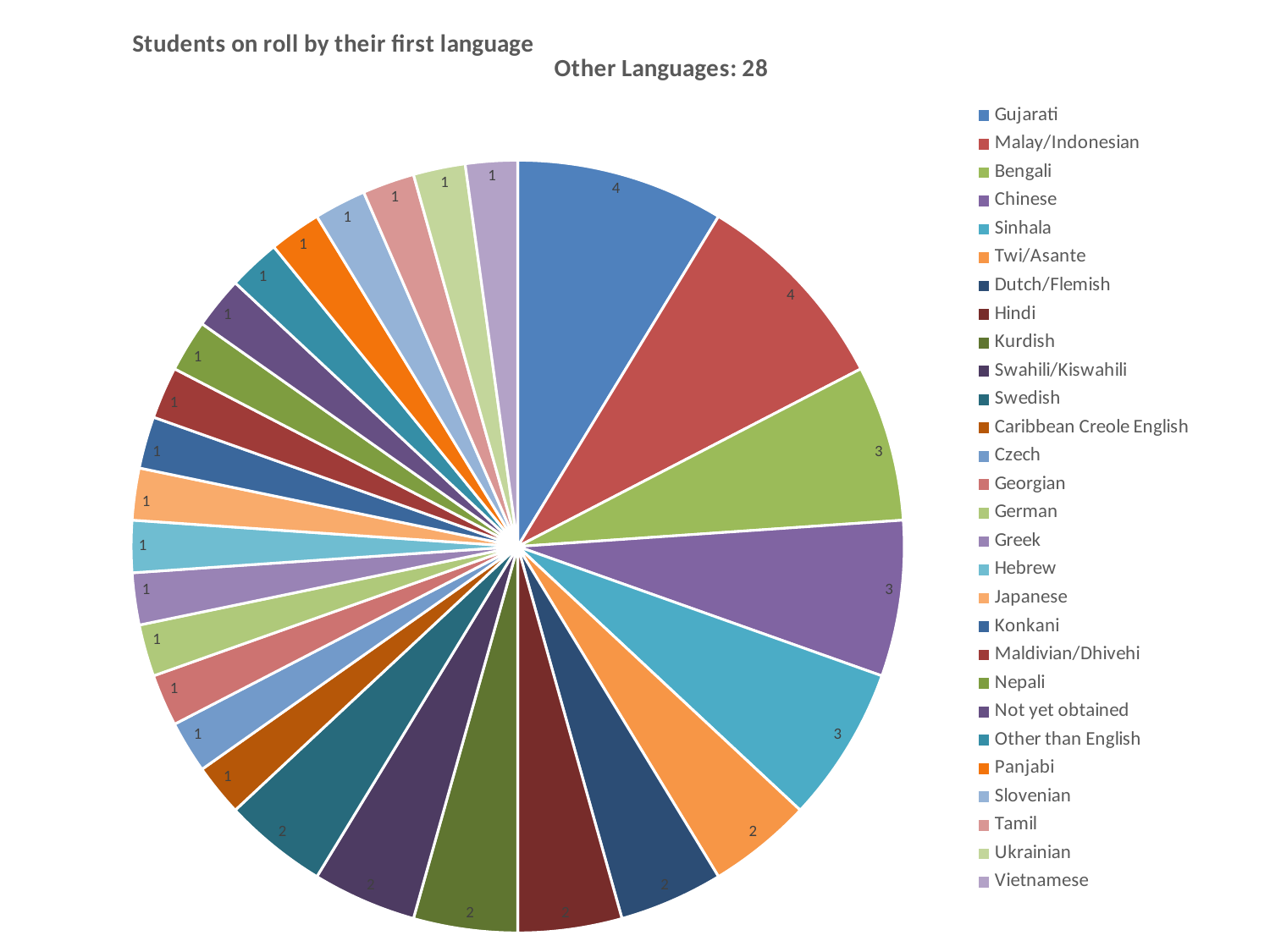
What is the title of the pie chart? Students on roll by their first language Other Languages: 28 How many entries does the legend of the pie chart list? 28 What is the value for Gujarati in the pie chart? 4 What type of chart is shown on the slide? pie chart What is the value for Bengali in the pie chart? 3 What is the value for Twi/Asante in the pie chart? 2 What is the value for Vietnamese in the pie chart? 1 What is the difference between the values for Gujarati and Panjabi? 3 What is the value for Sinhala in the pie chart? 3 Which has a larger value, Bengali or Hindi? Bengali What is the difference between the values for Malay/Indonesian and Chinese? 1 Which has a larger value, Swedish or Czech? Swedish